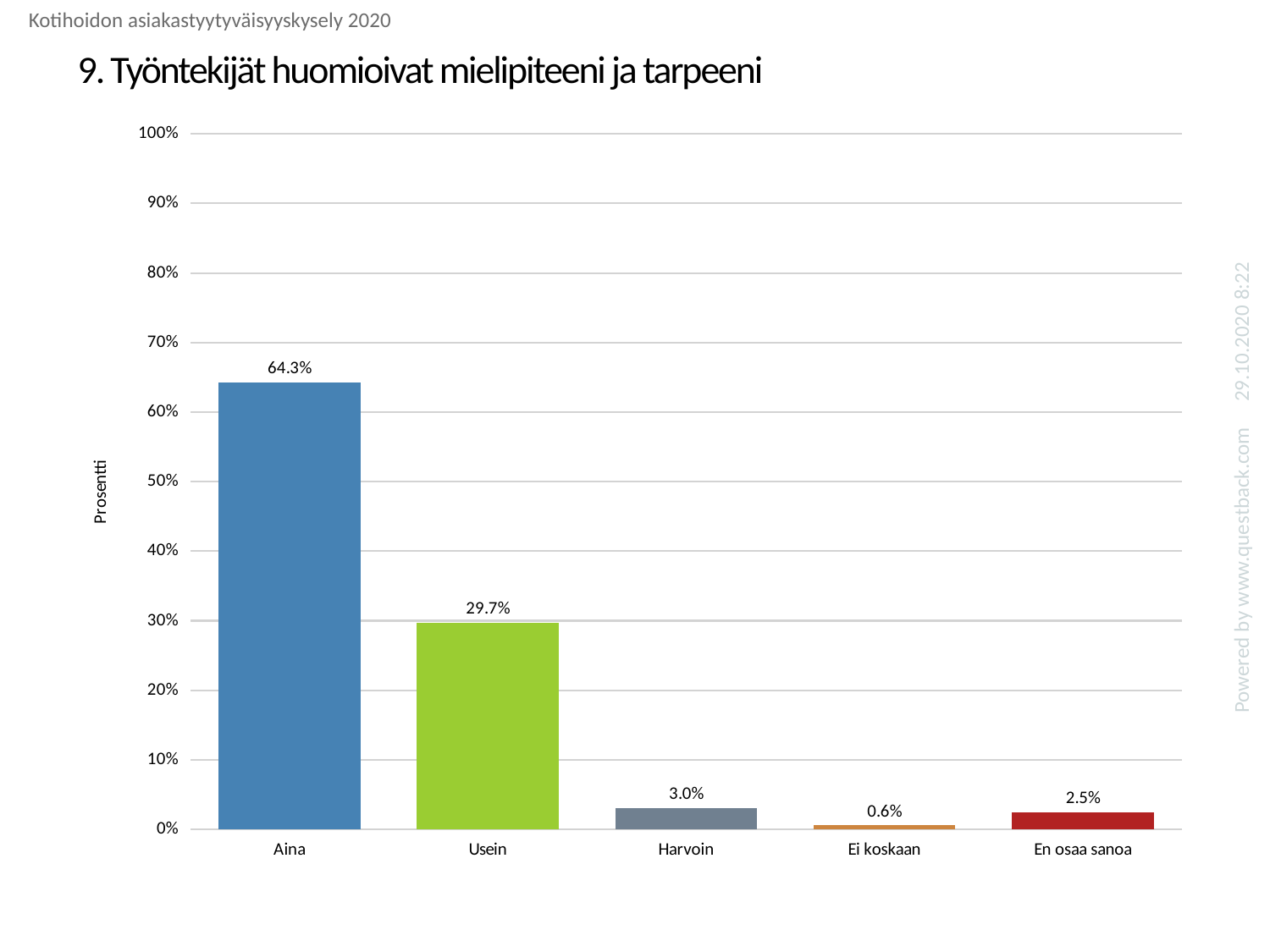
What kind of chart is shown on the slide? bar chart What is the value for Ei koskaan? 0.6% What is the value for Usein? 29.7% What is the value for En osaa sanoa? 2.5% What is the value for Aina? 64.3% Which category has the lowest value? Ei koskaan What is the value for Harvoin? 3.0% What is the difference between the values for Aina and Usein? 34.6% Is the value for Aina greater or less than 60%? greater How many categories are shown on the x axis? 5 Which category has the highest value? Aina Which is larger, the value for Harvoin or the value for En osaa sanoa? Harvoin